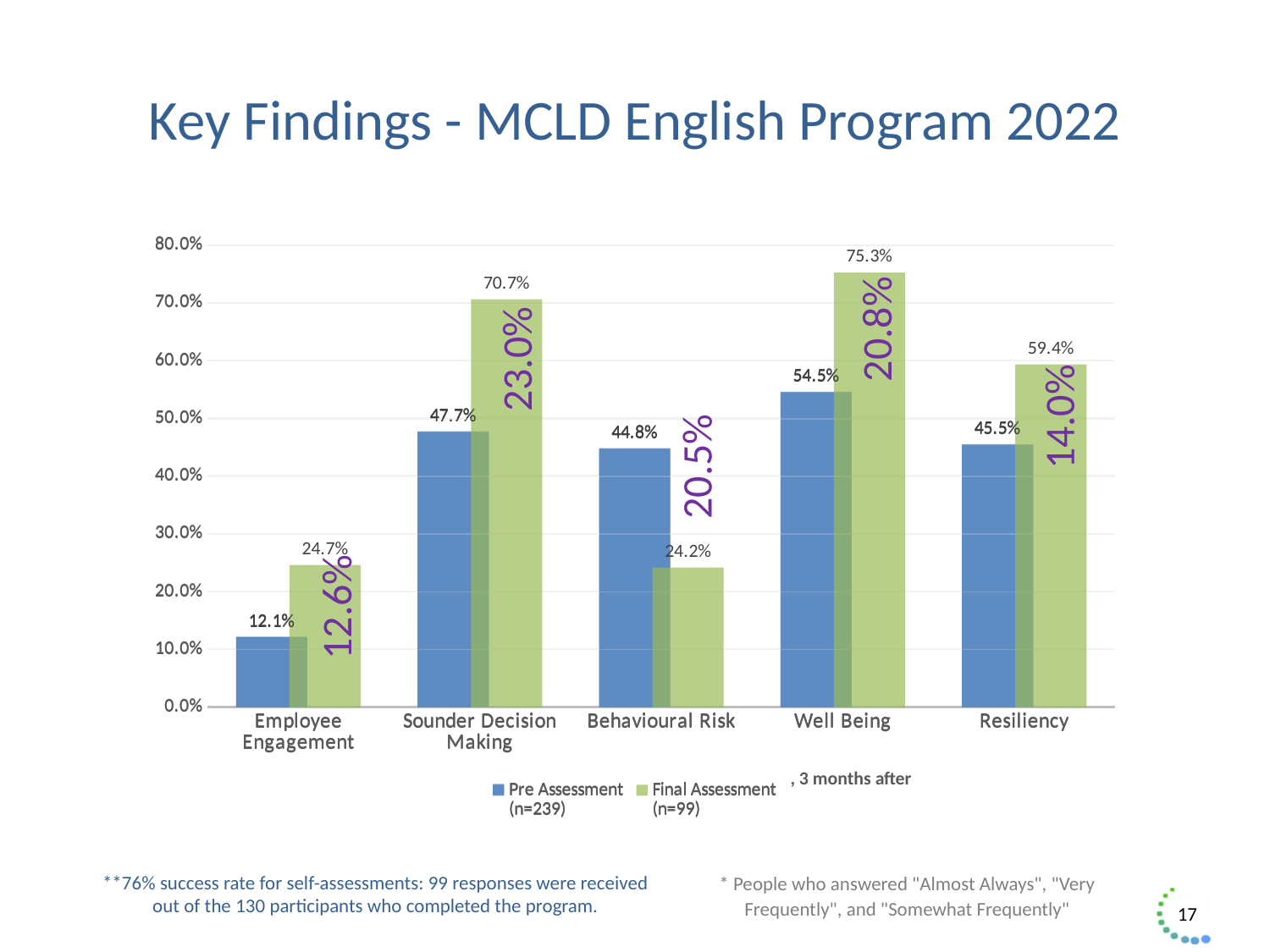
How many categories are shown on the x axis? 5 Is the Pre Assessment value for Sounder Decision Making greater or less than 50.0%? less What is the sample size (n) given in the legend for the Final Assessment series? n=99 How many series does the legend list? 2 Which category has the lowest Final Assessment value? Behavioural Risk What is the difference between the Final Assessment and Pre Assessment values for Resiliency? 13.9% What is the Final Assessment value for Well Being? 75.3% What kind of chart is shown on the slide? Bar chart Which is larger for Behavioural Risk: the Pre Assessment value or the Final Assessment value? Pre Assessment Which category has the highest Pre Assessment value? Well Being What is the Final Assessment value for Sounder Decision Making? 70.7% What is the Pre Assessment value for Employee Engagement? 12.1%